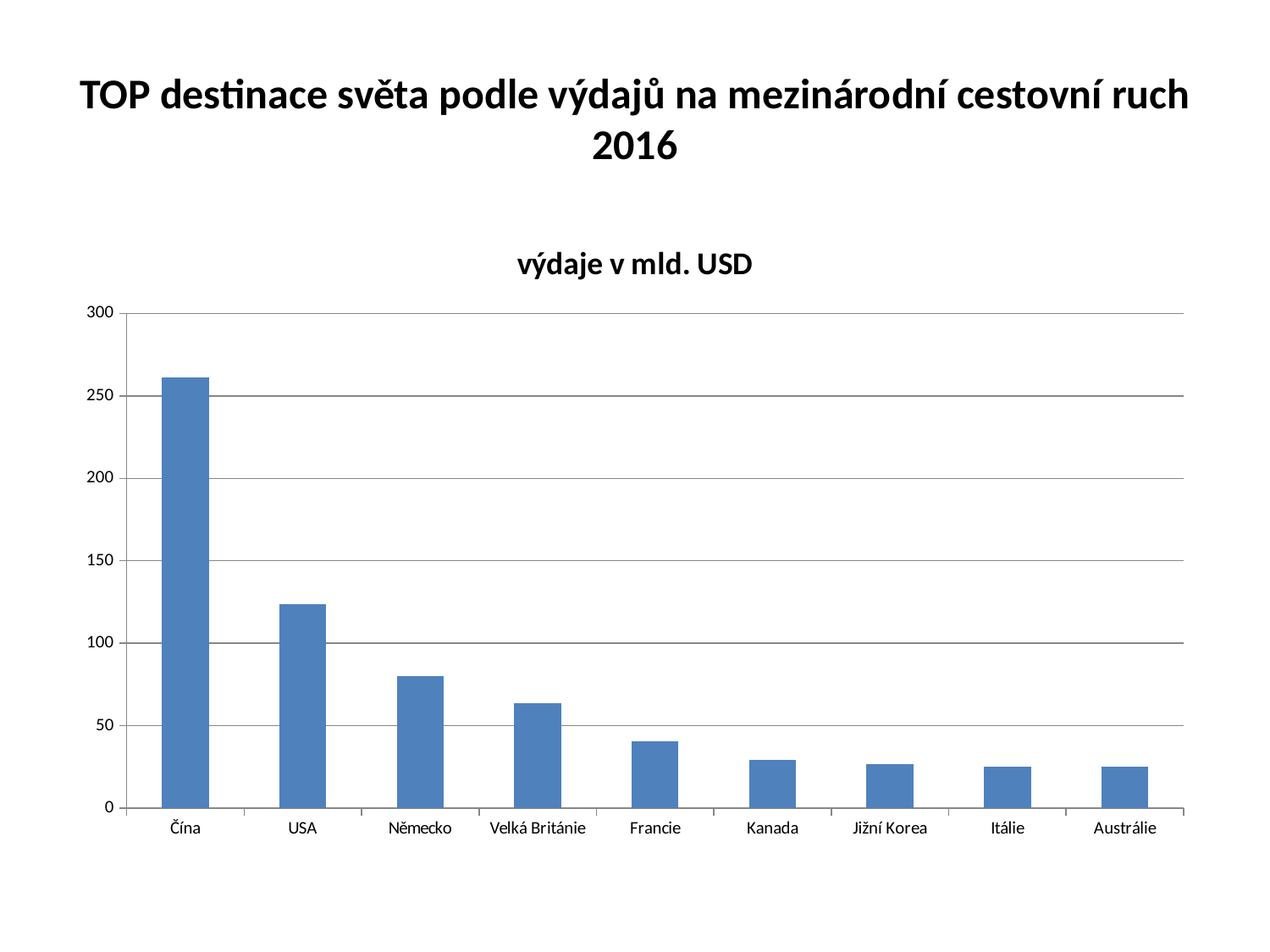
What is the title shown above the chart? výdaje v mld. USD What kind of chart is shown on the slide? bar chart Is the value for Německo greater or less than 100? less How many countries are shown on the x axis of the chart? 9 Is the value for Velká Británie greater or less than 50? greater Is the value for Kanada greater or less than 50? less Do the values rise or fall moving from left to right along the x axis? fall Which country has the highest value in the chart? Čína Which is larger, the value for USA or the value for Německo? USA